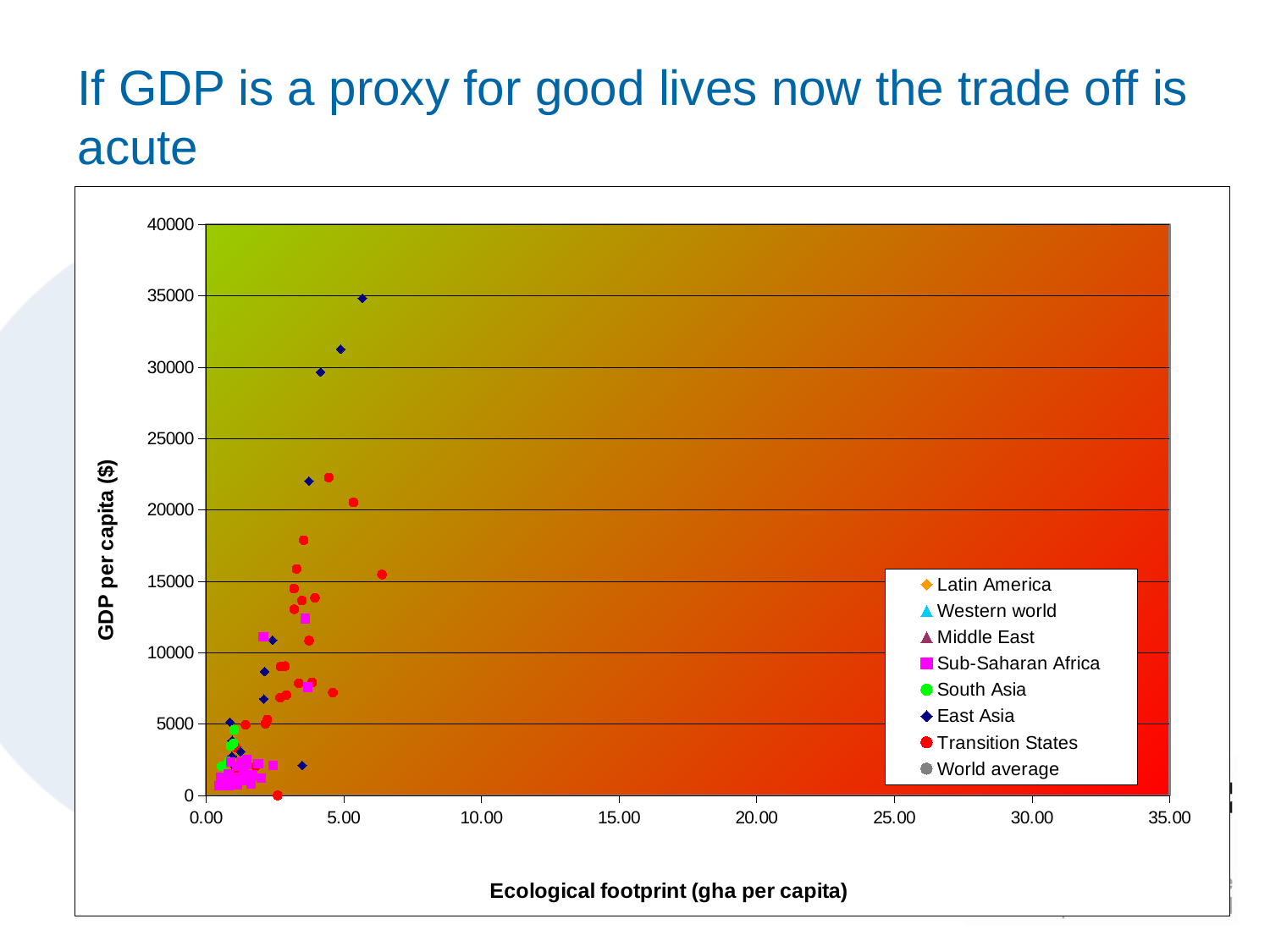
What is the title of the horizontal axis? Ecological footprint (gha per capita) Is the GDP per capita of the highest Transition States point greater or less than 20000? greater Which series has a higher maximum GDP per capita, East Asia or South Asia? East Asia Are all plotted points at an ecological footprint greater or less than 10.00? less Is the GDP per capita of the highest East Asia point greater or less than 30000? greater What kind of chart is shown on the slide? scatter chart What is the title of the vertical axis? GDP per capita ($) How many series does the legend list? 8 Which series has the point with the highest GDP per capita? East Asia What is the maximum value shown on the horizontal axis? 35.00